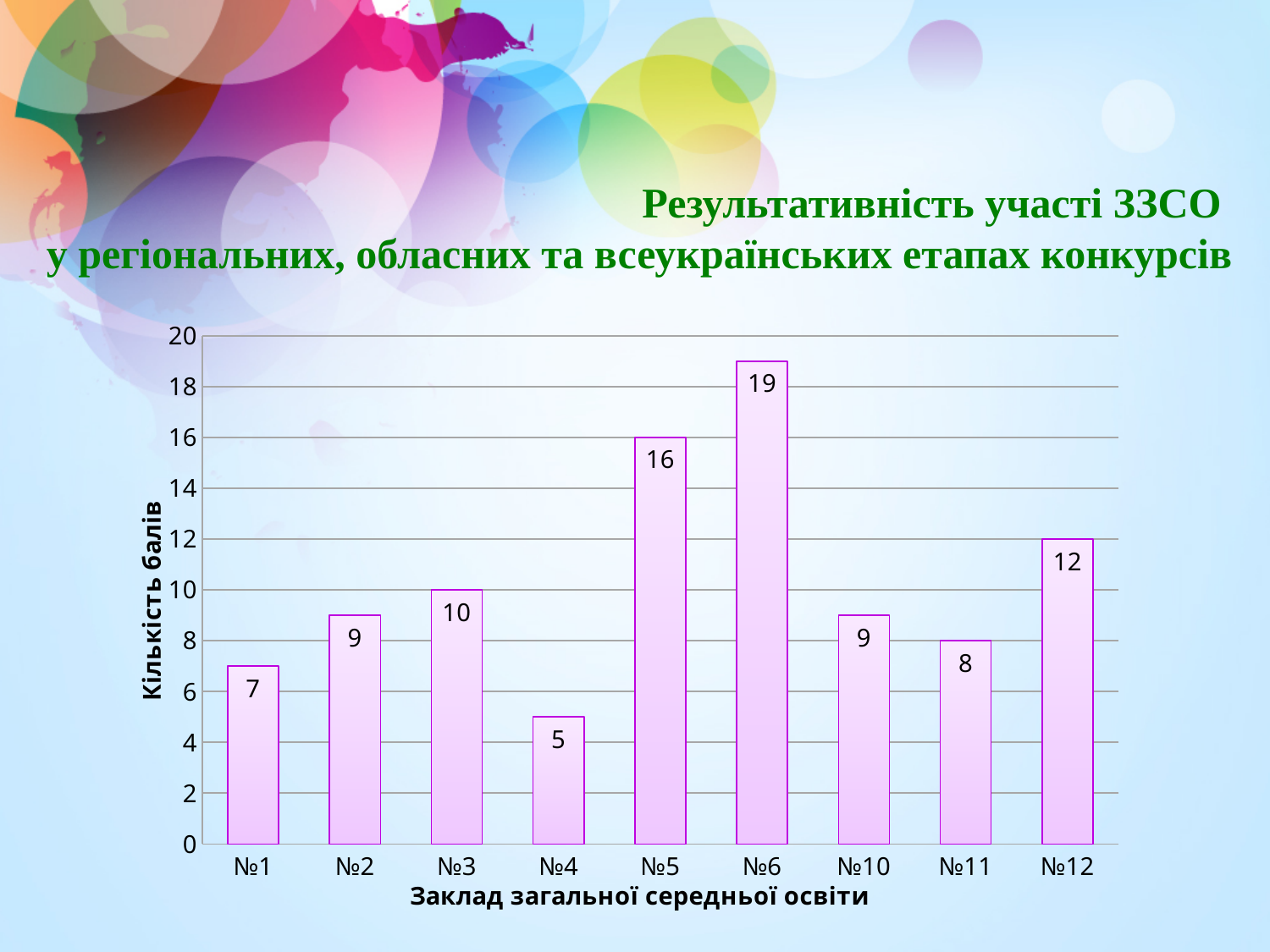
What is the value for №4? 5 How many categories are shown on the x axis? 9 What kind of chart is shown on the slide? bar chart What is the label of the y axis? Кількість балів What is the value for №6? 19 What is the value for №12? 12 What is the difference between the values for №6 and №5? 3 Which category has the highest value? №6 Which category has the lowest value? №4 What is the difference between the values for №12 and №1? 5 Is the value for №5 greater or less than 14? greater Which is larger, the value for №3 or the value for №11? №3